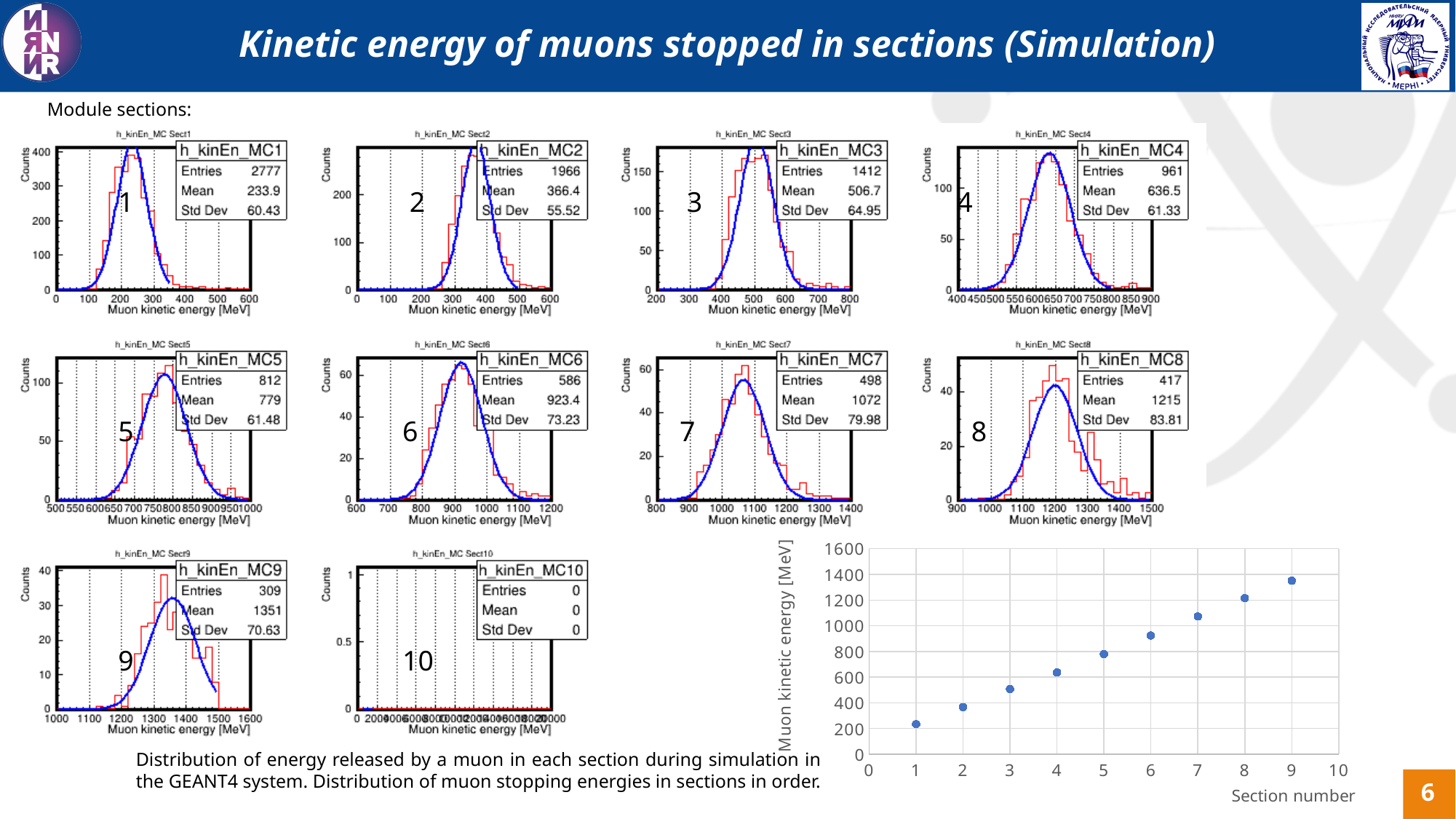
In the bottom-right scatter plot, is the muon kinetic energy for section 1 greater or less than 400 MeV? less What is the difference in entries between the histogram for section 1 and the histogram for section 2? 811 In the histogram h_kinEn_MC Sect8, what is the Std Dev listed in the statistics box? 83.81 What kind of chart is the bottom-right plot of muon kinetic energy versus section number? scatter plot In the histogram h_kinEn_MC Sect4, what is the Mean listed in the statistics box? 636.5 Which has more entries, the histogram for section 5 or the histogram for section 6? section 5 In the bottom-right scatter plot, is the muon kinetic energy for section 3 greater or less than 400 MeV? greater In the bottom-right scatter plot, is the muon kinetic energy for section 9 greater or less than 1200 MeV? greater In the bottom-right scatter plot of muon kinetic energy versus section number, how many data points are plotted? 9 In the bottom-right scatter plot of muon kinetic energy versus section number, do the values rise or fall as the section number increases? rise In the histogram h_kinEn_MC Sect1, how many entries are listed in the statistics box? 2777 Which of the ten section histograms has the highest number of entries in its statistics box? h_kinEn_MC Sect1